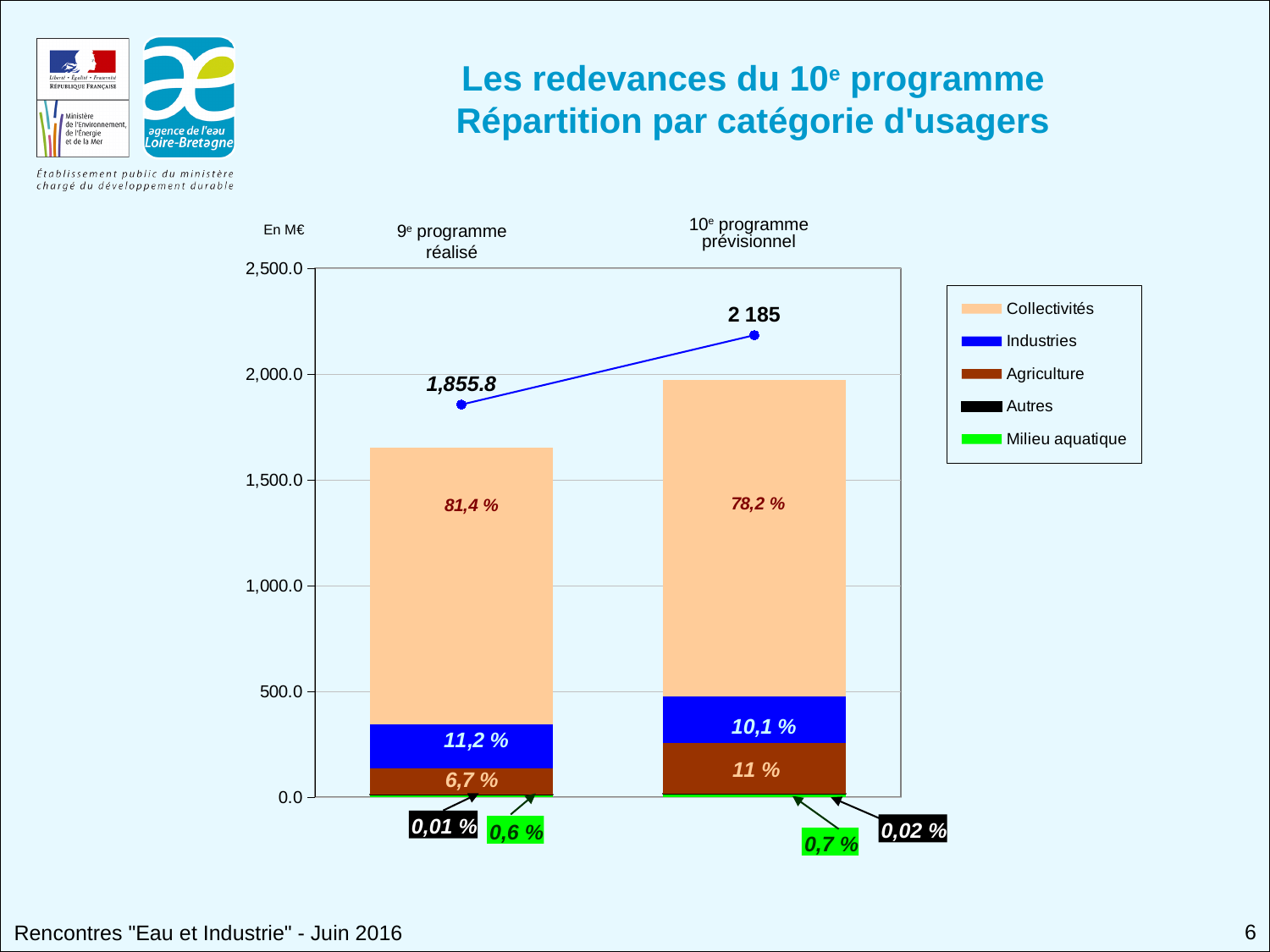
What unit is indicated for the y axis? En M€ What share of the 10e programme prévisionnel is labelled for Agriculture? 11 % How many series does the legend list? 5 Is the total for the 10e programme prévisionnel greater or less than 2,000.0? greater Which programme has the higher labelled total, the 9e programme réalisé or the 10e programme prévisionnel? 10e programme prévisionnel How many programme categories are plotted on the x axis? 2 What kind of chart is shown on the slide? combination stacked bar and line chart What share of the 9e programme réalisé is labelled for Milieu aquatique? 0,6 % What total value is labelled for the 9e programme réalisé? 1,855.8 What share of the 10e programme prévisionnel is labelled for Industries? 10,1 % What share of the 9e programme réalisé is labelled for Collectivités? 81,4 % What total value is labelled for the 10e programme prévisionnel? 2 185